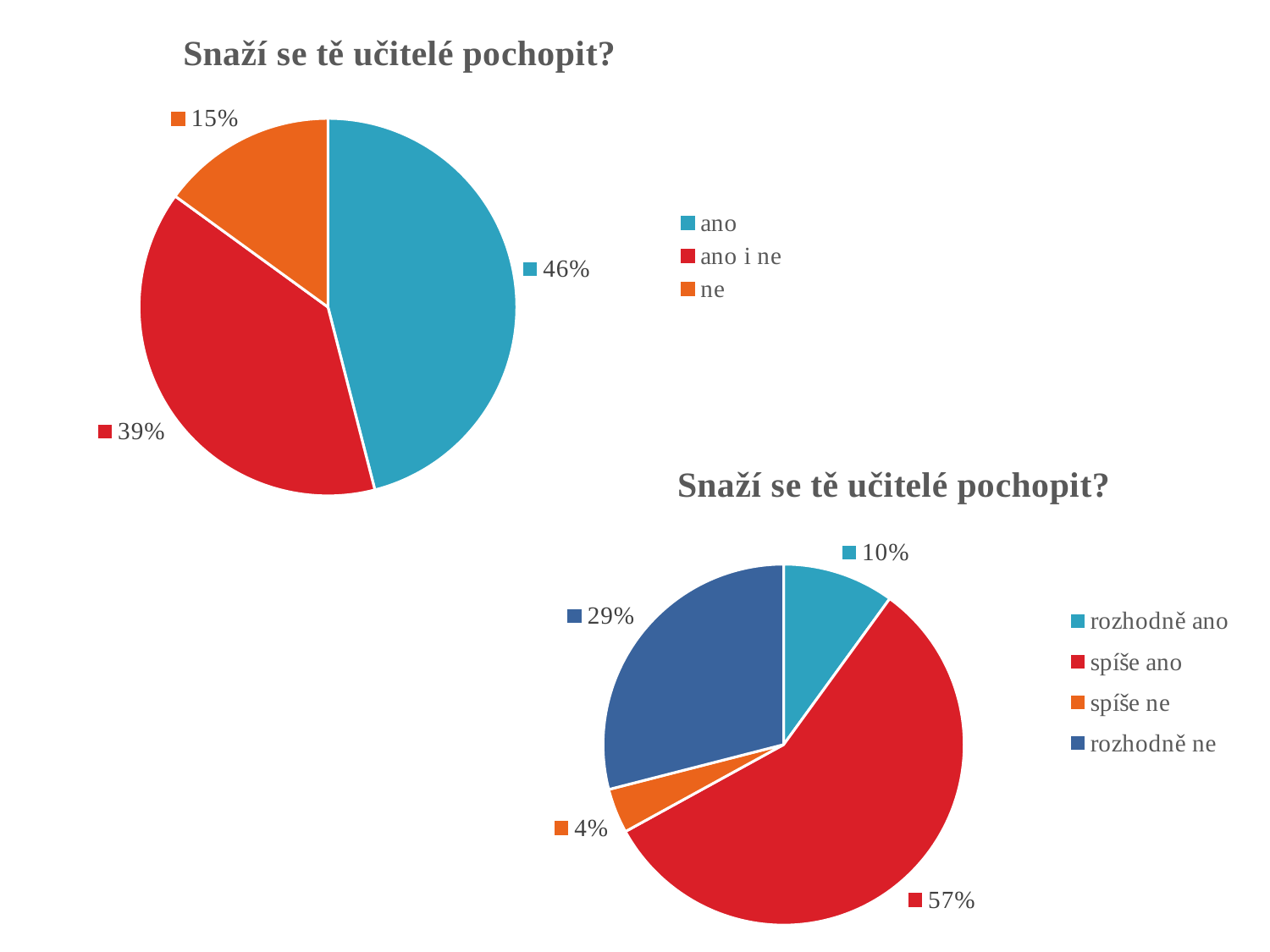
In the bottom-right pie chart, what share of respondents answered "spíše ano"? 57% In the top-left pie chart, what is the difference in percentage points between "ano" and "ne"? 31 How many slices does the bottom-right pie chart have? 4 In the bottom-right pie chart, which is larger: "rozhodně ano" or "rozhodně ne"? rozhodně ne In the top-left pie chart, what share of respondents answered "ano"? 46% How many categories does the legend of the top-left pie chart list? 3 In the bottom-right pie chart, which category has the smallest share? spíše ne In the top-left pie chart, what percentage is shown for "ano i ne"? 39% What type of chart is shown in the bottom-right of the slide? Pie chart In the top-left pie chart, which category has the smallest share? ne In the bottom-right pie chart, which category has the largest share? spíše ano In the bottom-right pie chart, what percentage is shown for "rozhodně ne"? 29%